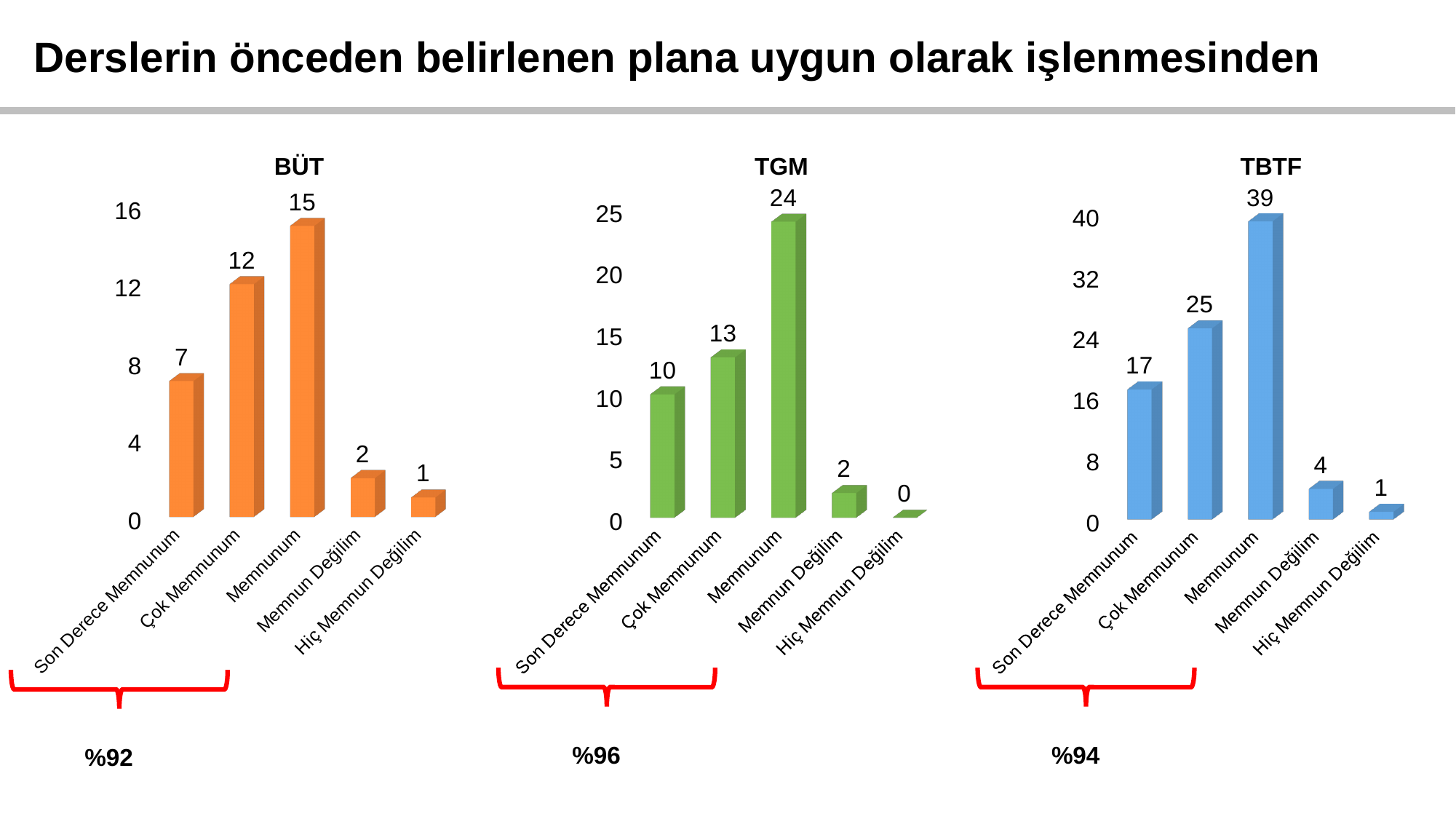
In the TGM chart, what is the value for Son Derece Memnunum? 10 In the BÜT chart, what is the value for Memnunum? 15 What is the title of the chart on the left of the slide? BÜT In the TGM chart, which category has the lowest value? Hiç Memnun Değilim In the TBTF chart, what is the difference between the values for Memnunum and Son Derece Memnunum? 22 In the TBTF chart, what is the value for Çok Memnunum? 25 How many categories are shown in the TGM chart? 5 What kind of chart is the BÜT chart? bar chart In the TGM chart, which is larger: the value for Çok Memnunum or the value for Son Derece Memnunum? Çok Memnunum In the TBTF chart, which category has the highest value? Memnunum In the TBTF chart, what is the value for Hiç Memnun Değilim? 1 In the BÜT chart, what is the difference between the values for Memnunum and Çok Memnunum? 3